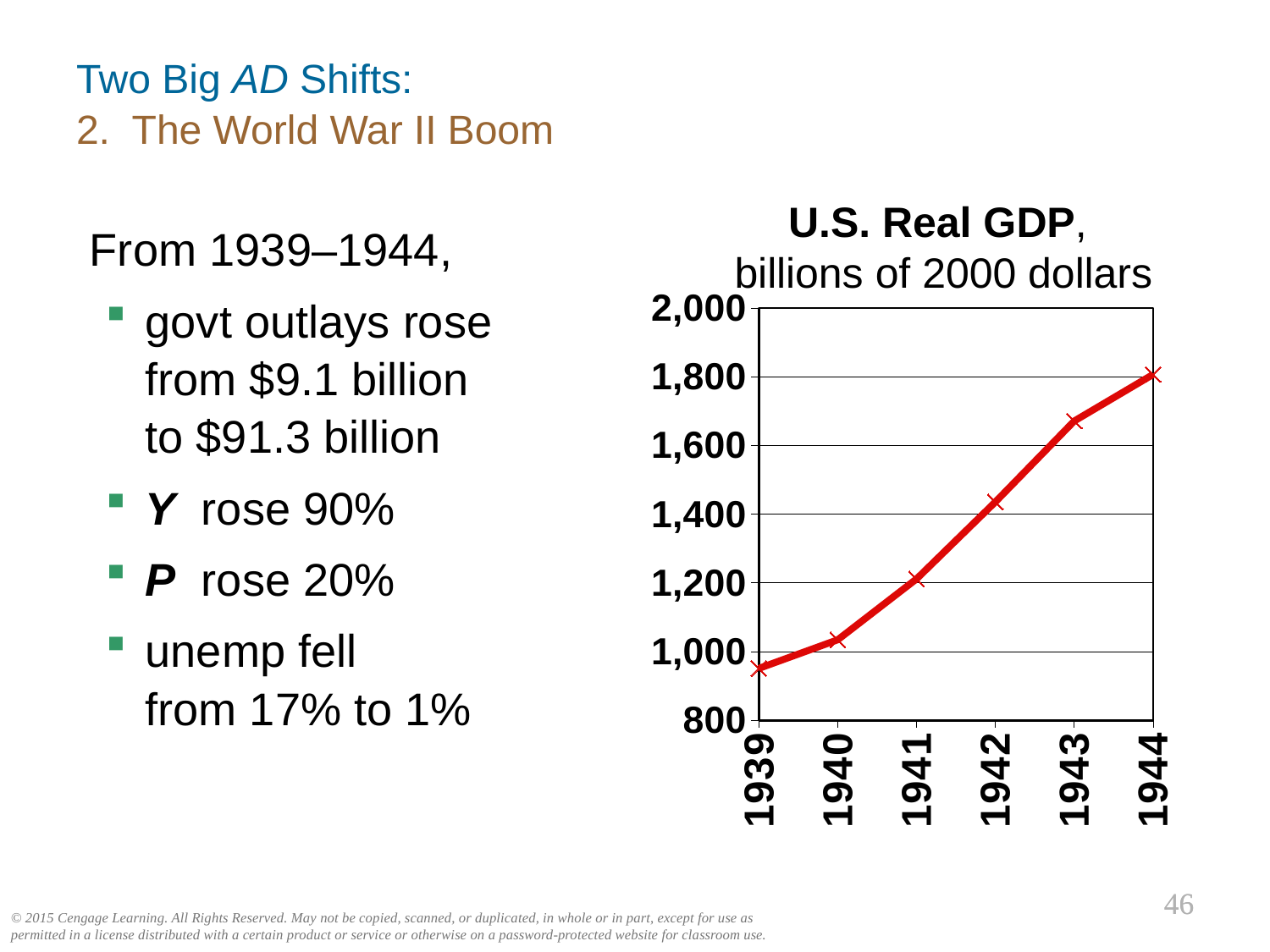
What is the title of the chart? U.S. Real GDP, billions of 2000 dollars Does U.S. Real GDP rise or fall from 1939 to 1944 in the chart? rise Which year has the larger U.S. Real GDP, 1941 or 1943? 1943 Is the value for 1944 greater or less than 2,000? less Is the value for 1941 greater or less than 1,400? less What is the first year shown on the x axis of the chart? 1939 How many years are plotted on the x axis of the chart? 6 Is the value for 1943 greater or less than 1,600? greater Which year has the lowest U.S. Real GDP in the chart? 1939 Which year has the highest U.S. Real GDP in the chart? 1944 What kind of chart is shown on the slide? line chart